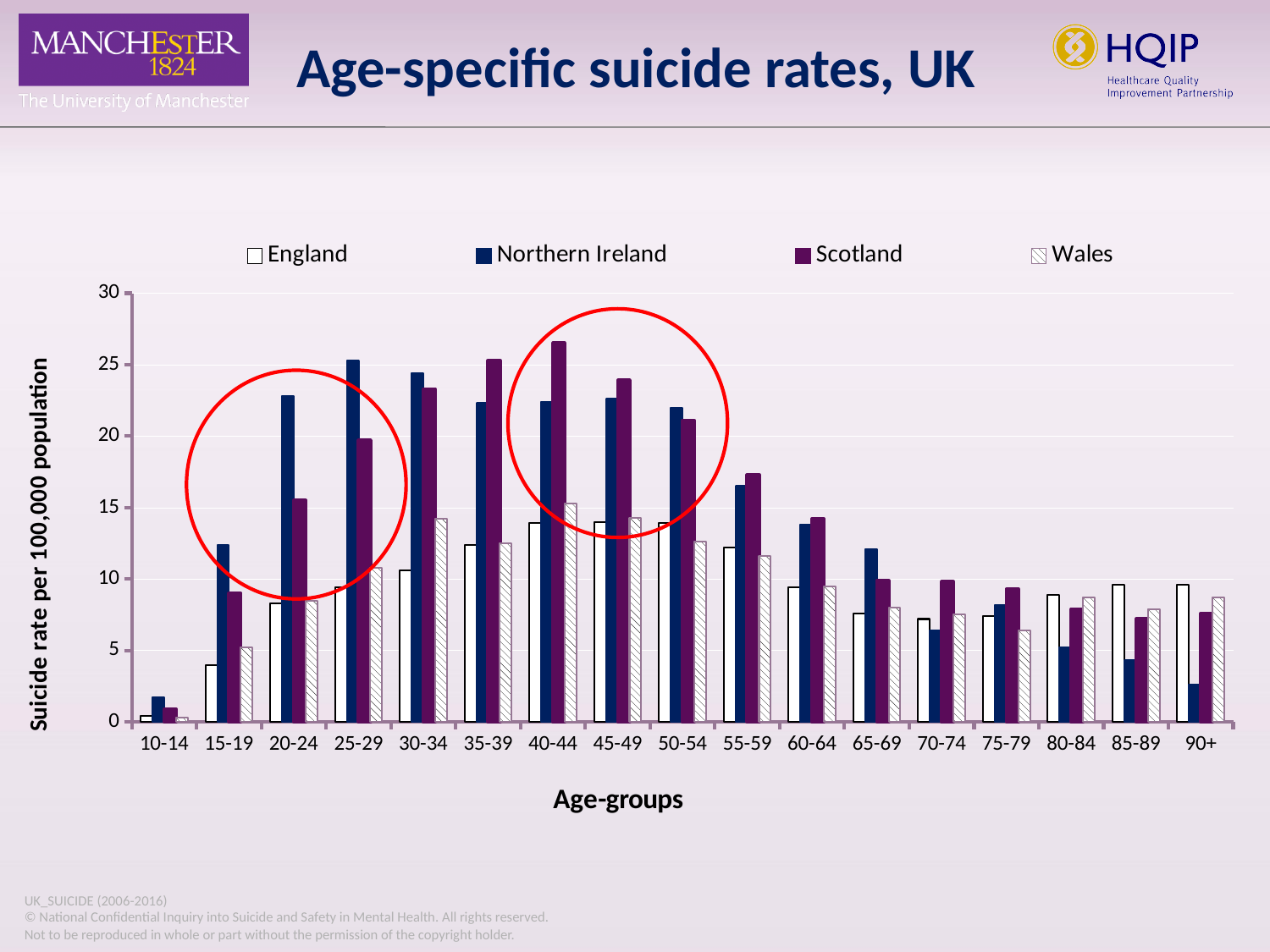
Is the Wales value for the 55-59 age group greater or less than 10? greater Is the Northern Ireland value for the 90+ age group greater or less than 5? less Which age group has the lowest England value? 10-14 For the 60-64 age group, which is larger: the England value or the Scotland value? Scotland Is the Northern Ireland value for the 20-24 age group greater or less than 20? greater What is the label of the y axis? Suicide rate per 100,000 population For the 20-24 age group, which is larger: the Northern Ireland value or the Scotland value? Northern Ireland How many series does the legend list? 4 What kind of chart is shown on the slide? bar chart How many age-group categories are shown on the x axis? 17